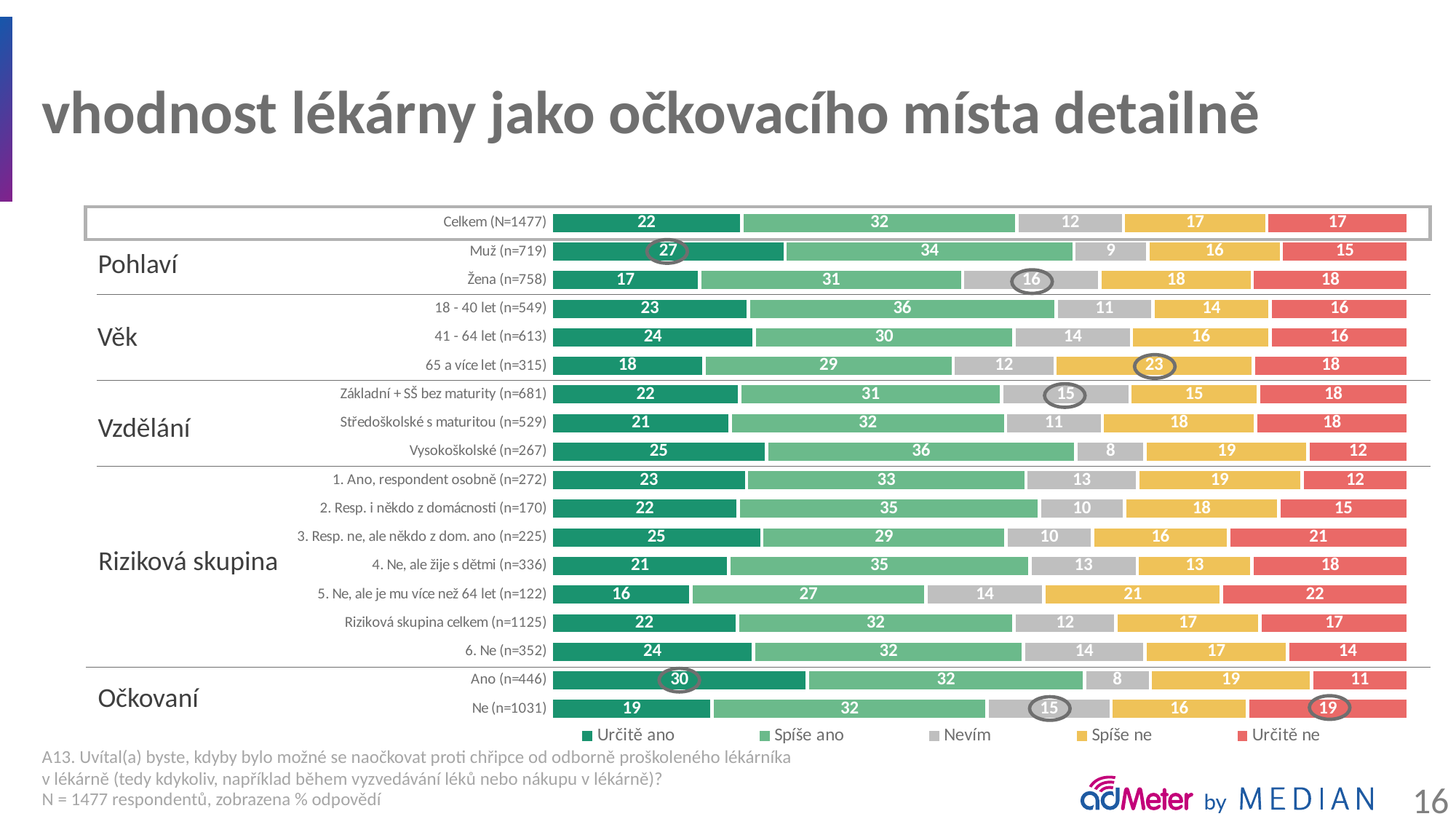
What is the value of "Spíše ne" for 65 a více let (n=315)? 23 How many series does the legend list? 5 What kind of chart is shown on the slide? stacked bar chart What is the value of "Určitě ano" for Celkem (N=1477)? 22 What is the difference between the "Určitě ano" values for Muž (n=719) and Žena (n=758)? 10 Which series is shown in yellow in the legend? Spíše ne What is the value of "Určitě ne" for Ne (n=1031) in the Očkovaní group? 19 Which category has the lowest "Určitě ano" value? 5. Ne, ale je mu více než 64 let (n=122) Which category has the highest "Určitě ano" value? Ano (n=446) What is the value of "Spíše ano" for Muž (n=719)? 34 What is the total of the "Určitě ano" and "Spíše ano" values for Vysokoškolské (n=267)? 61 Which has a larger "Nevím" value, Muž (n=719) or Žena (n=758)? Žena (n=758)